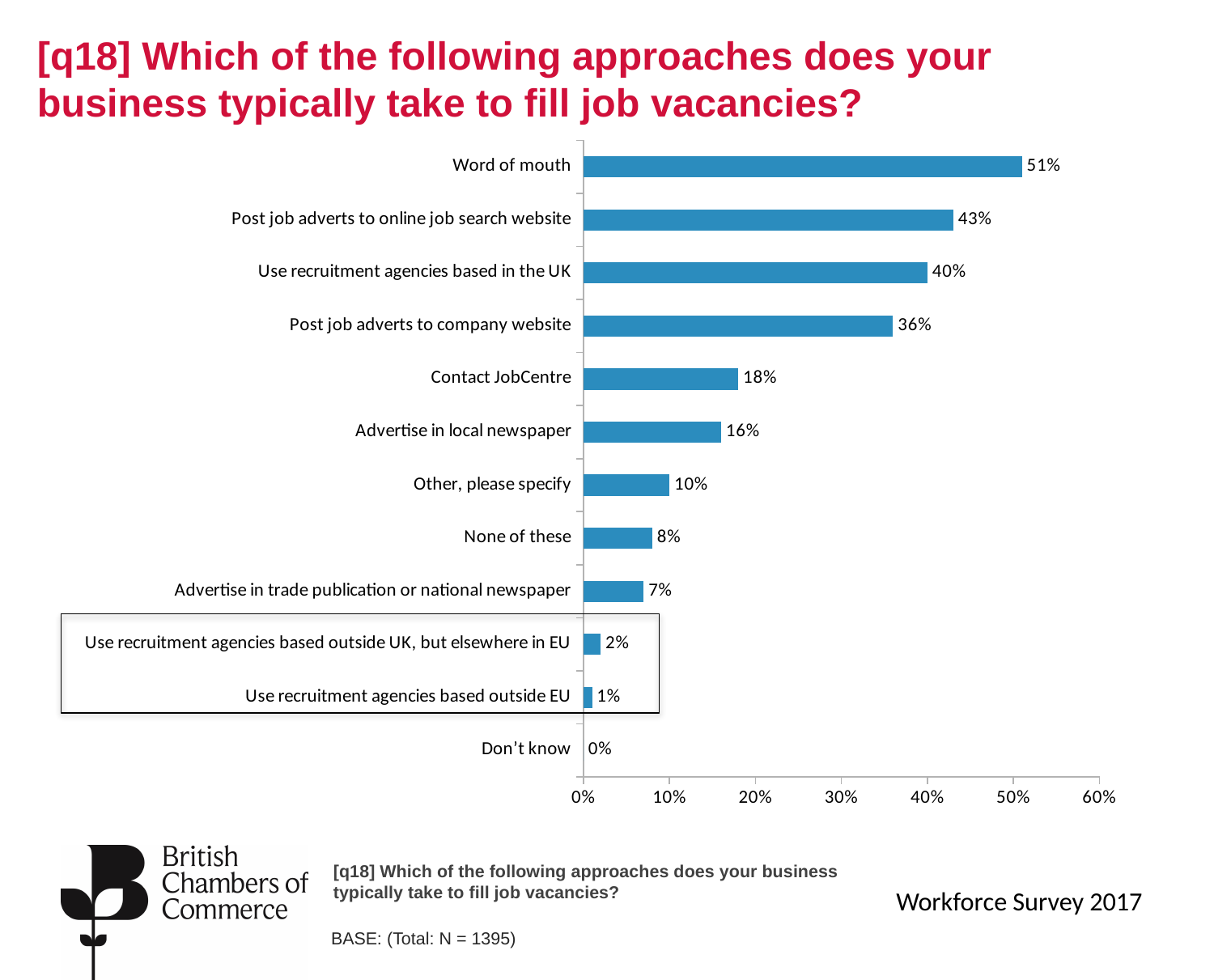
Which category has the lowest value on the chart? Don't know What percentage of businesses contact the JobCentre? 18% Which is larger: 'Advertise in local newspaper' or 'Other, please specify'? Advertise in local newspaper What kind of chart is shown on the slide? Bar chart How many categories are shown on the chart? 12 What is the maximum value shown on the horizontal axis? 60% Is the value for 'Post job adverts to company website' greater or less than 30%? greater What is the value for 'Use recruitment agencies based outside EU'? 1% Which approach has the highest percentage? Word of mouth What is the value for 'Use recruitment agencies based in the UK'? 40% What percentage of businesses use word of mouth to fill job vacancies? 51% What is the difference between 'Post job adverts to online job search website' and 'Post job adverts to company website'? 7%